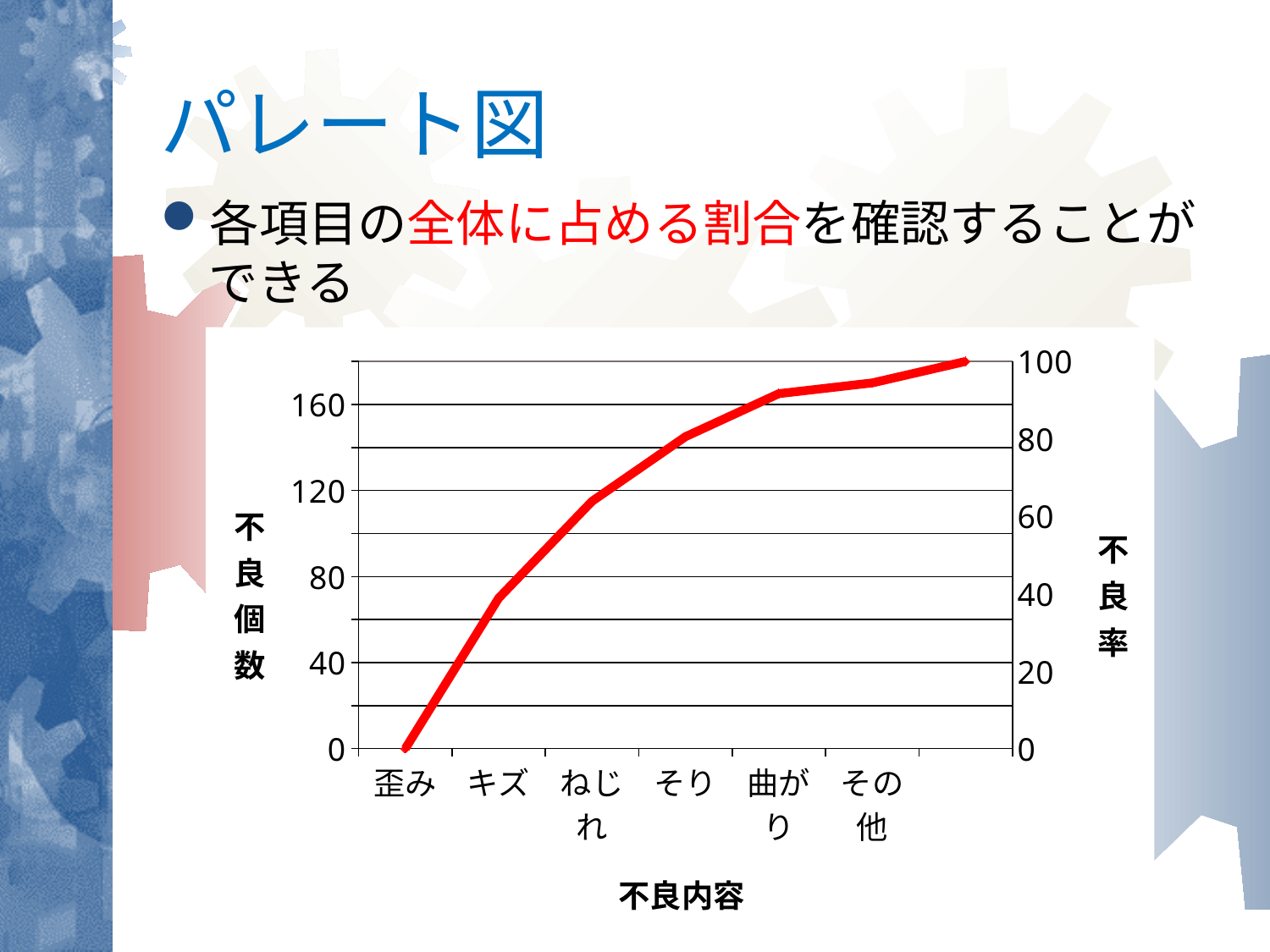
What is the title of the x axis of the chart? 不良内容 How many categories are labelled on the x axis of the chart? 6 What kind of chart is shown on the slide? line chart On the right-hand axis (不良率), is the value of the line at 曲がり greater or less than 80? greater What is the title of the right-hand y axis of the chart? 不良率 On the right-hand axis (不良率), is the value of the line at ねじれ greater or less than 40? greater Which category has the highest value on the red line among the labelled categories? その他 Is the value of the red line larger at そり or at キズ? そり Does the red line rise or fall from left to right along the x axis? rise On the right-hand axis (不良率), is the value of the line at そり greater or less than 60? greater Which category has the lowest value on the red line? 歪み